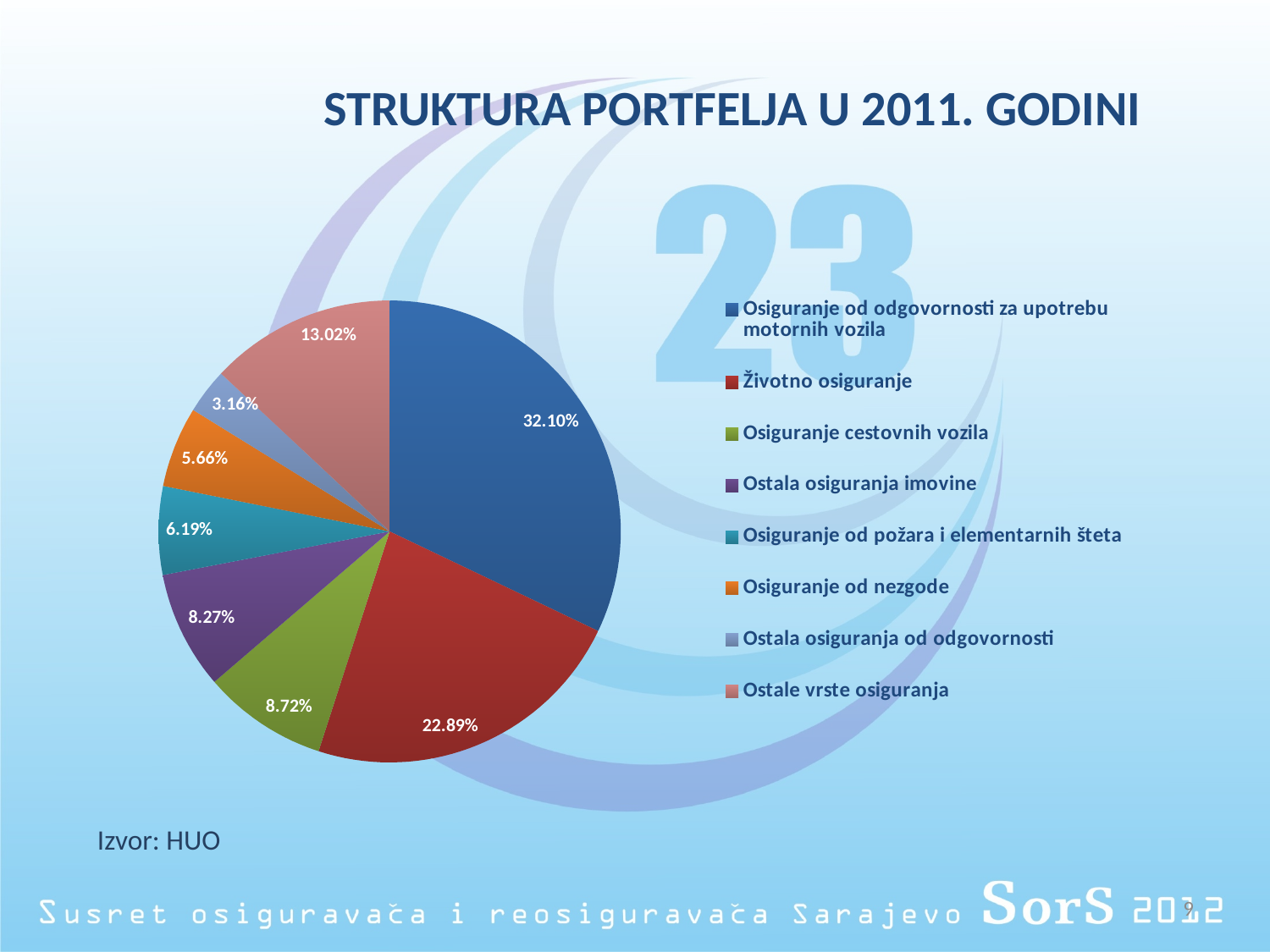
What is the source cited below the chart? Izvor: HUO What is the title of the chart on the slide? STRUKTURA PORTFELJA U 2011. GODINI How many slices does the pie chart have? 8 What type of chart is shown on the slide? Pie chart What share of the pie is Osiguranje od odgovornosti za upotrebu motornih vozila? 32.10% What is the difference between the shares of Osiguranje od odgovornosti za upotrebu motornih vozila and Životno osiguranje? 9.21% Which is larger, the share for Osiguranje cestovnih vozila or the share for Osiguranje od nezgode? Osiguranje cestovnih vozila Which category has the smallest slice of the pie? Ostala osiguranja od odgovornosti What is the value shown for Osiguranje od požara i elementarnih šteta? 6.19% Which category has the largest slice of the pie? Osiguranje od odgovornosti za upotrebu motornih vozila What share of the pie is Životno osiguranje? 22.89% What is the value shown for Ostale vrste osiguranja? 13.02%